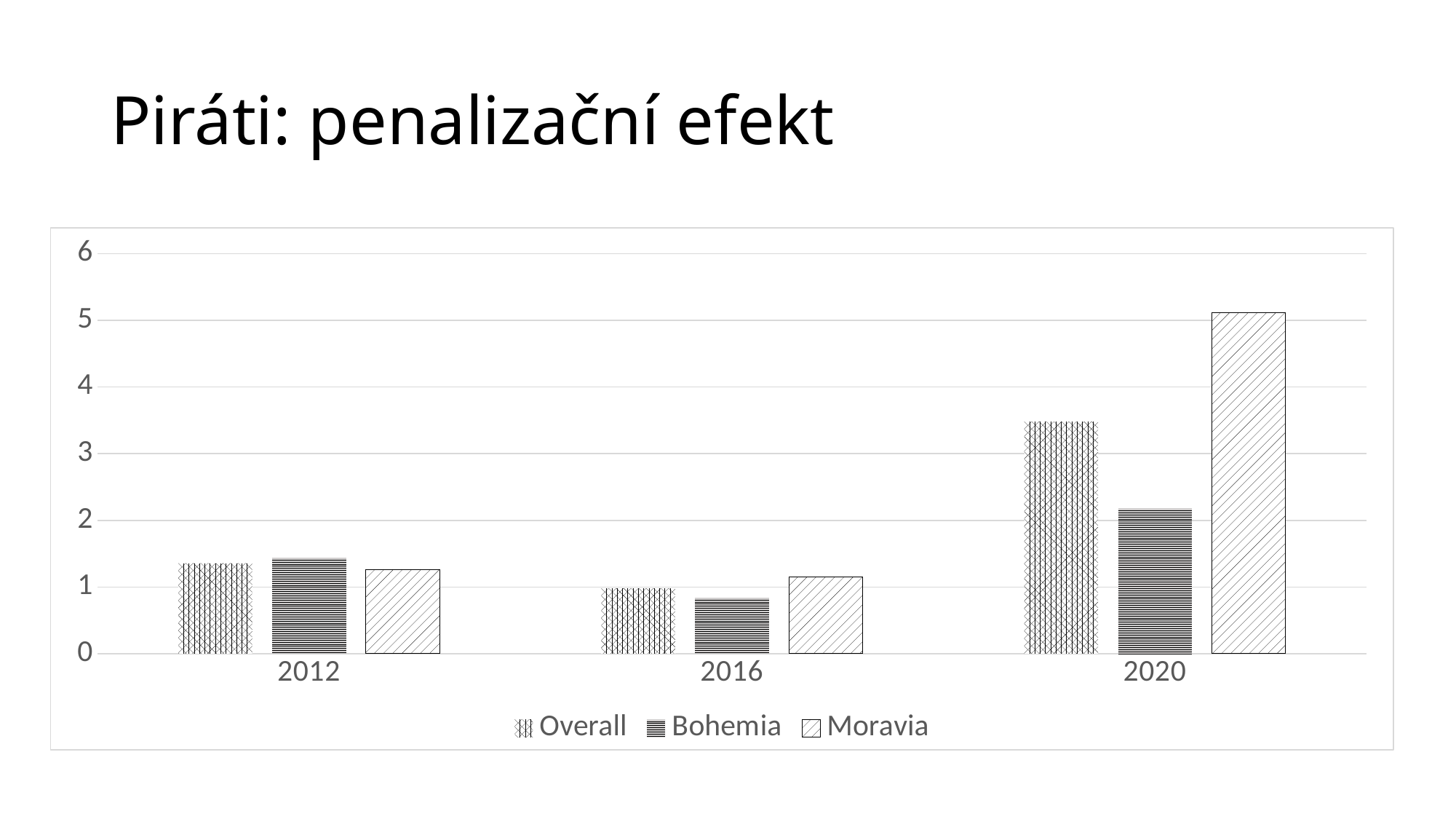
Which series has the lowest bar in 2016? Bohemia Which series has the highest bar in 2020? Moravia How many years are shown on the x axis of the chart? 3 What kind of chart is shown on the slide? bar chart Which is larger in 2016, the Moravia bar or the Bohemia bar? Moravia Is the value for Moravia in 2020 greater or less than 5? greater What is the title of the slide containing the chart? Piráti: penalizační efekt Which is larger in 2020, the Overall bar or the Bohemia bar? Overall How many series does the chart legend list? 3 Is the value for Bohemia in 2016 greater or less than 1? less Is the value for Overall in 2020 greater or less than 3? greater In which year is the Moravia bar the tallest? 2020